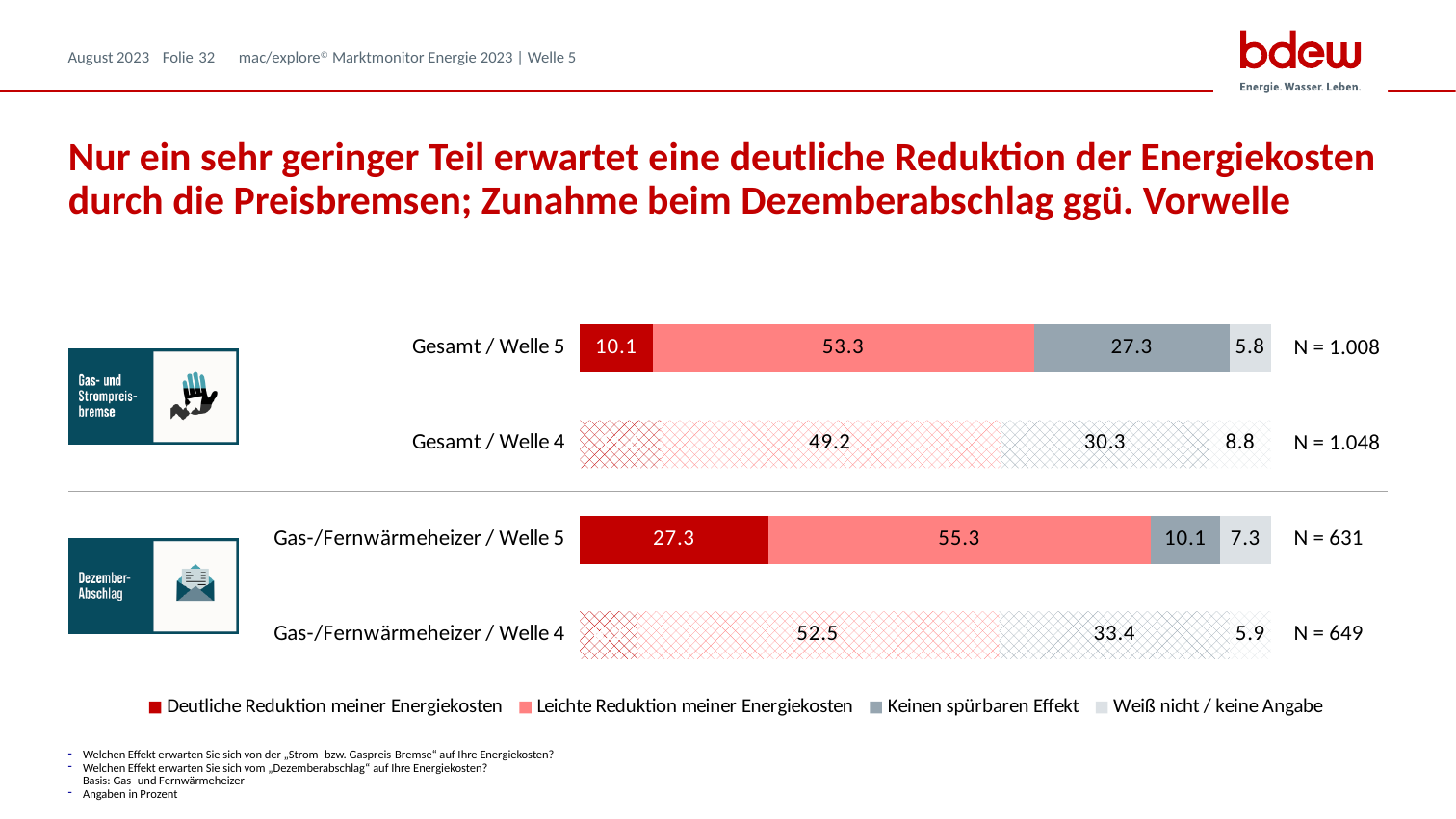
What kind of chart is shown on the slide? stacked bar chart Which is larger: the "Keinen spürbaren Effekt" value for Gesamt / Welle 5 or for Gas-/Fernwärmeheizer / Welle 5? Gesamt / Welle 5 What is the difference between the "Leichte Reduktion meiner Energiekosten" values for Gesamt / Welle 5 and Gesamt / Welle 4? 4.1 What is the value for "Deutliche Reduktion meiner Energiekosten" in the Gesamt / Welle 5 bar? 10.1 Which bar has the highest value for "Deutliche Reduktion meiner Energiekosten" among the labelled values? Gas-/Fernwärmeheizer / Welle 5 What is the sample size (N) shown for the Gas-/Fernwärmeheizer / Welle 5 bar? N = 631 What is the value for "Leichte Reduktion meiner Energiekosten" in the Gas-/Fernwärmeheizer / Welle 5 bar? 55.3 What is the value for "Weiß nicht / keine Angabe" in the Gas-/Fernwärmeheizer / Welle 4 bar? 5.9 What is the difference between the "Deutliche Reduktion meiner Energiekosten" values for Gas-/Fernwärmeheizer / Welle 5 and Gesamt / Welle 5? 17.2 How many series does the legend list? 4 What is the value for "Keinen spürbaren Effekt" in the Gesamt / Welle 4 bar? 30.3 How many bars (rows) are shown in the chart? 4